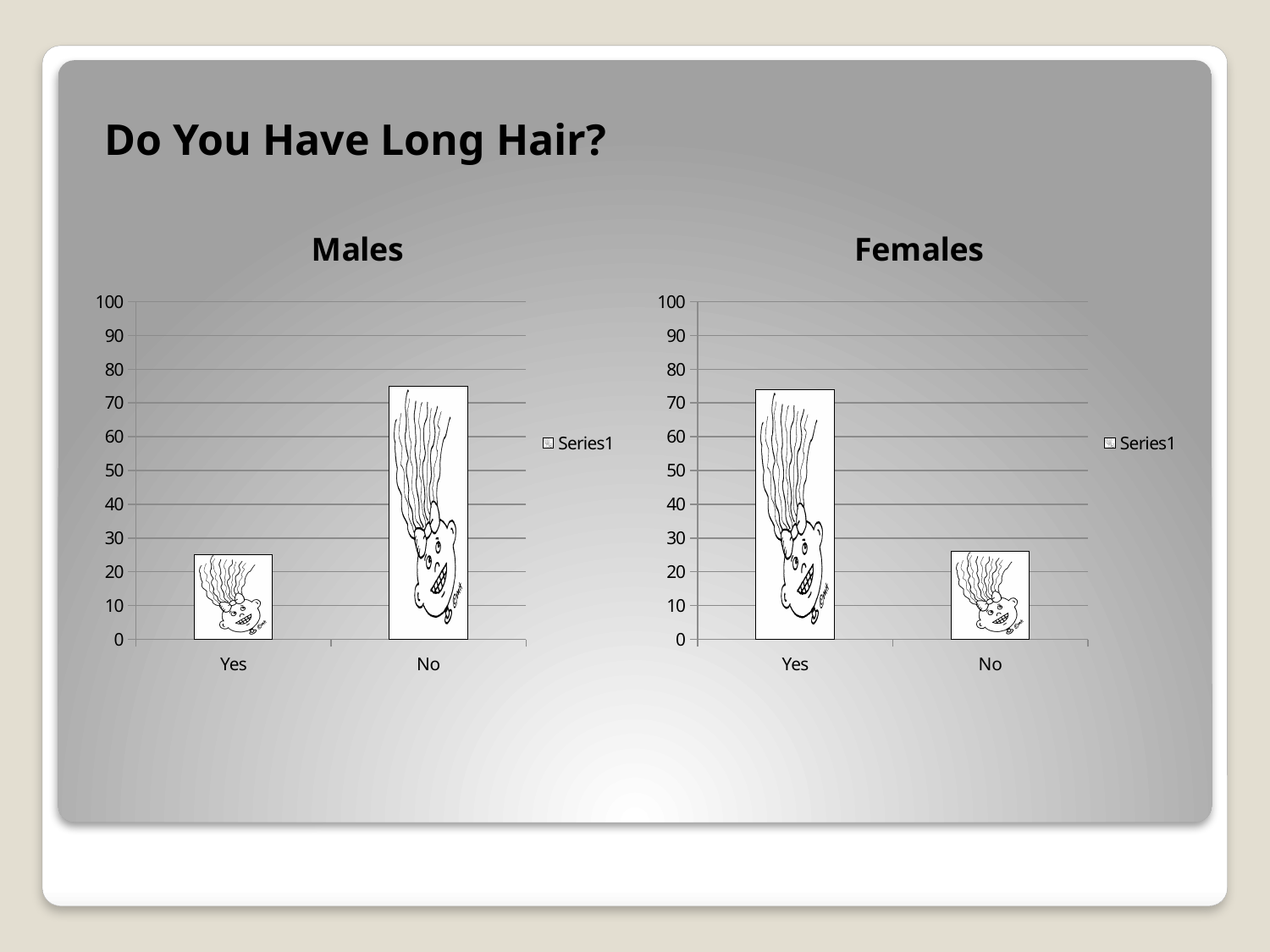
On the Males chart, which category has the higher value, Yes or No? No How many series does the legend of the Females chart list? 1 On the Females chart, is the value for Yes greater or less than 70? greater On the Females chart, is the value for No greater or less than 50? less On the Males chart, which category has the lowest value? Yes How many categories are shown on the Males chart? 2 What is the title of the chart on the right side of the slide? Females On the Males chart, is the value for No greater or less than 70? greater On the Females chart, which category has the lowest value? No What kind of chart is the Males chart? bar chart On the Females chart, which category has the highest value? Yes